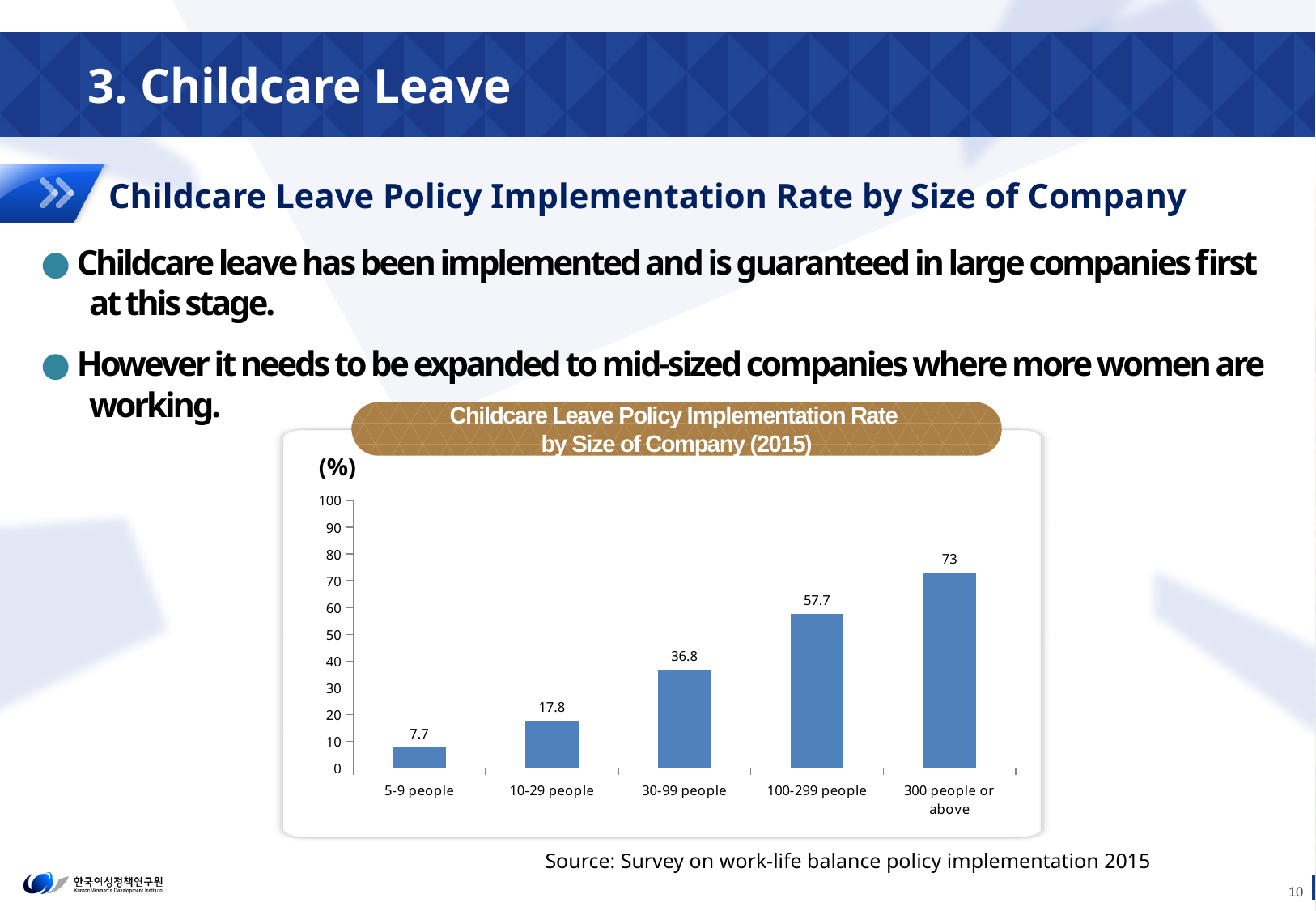
Which company size category has the lowest implementation rate? 5-9 people What year is given in the chart title? 2015 Which company size category has the highest implementation rate? 300 people or above What is the difference between the implementation rates for companies with 300 people or above and companies with 10-29 people? 55.2 How many company size categories are shown in the chart? 5 What is the implementation rate for companies with 30-99 people? 36.8 What is the childcare leave policy implementation rate for companies with 5-9 people? 7.7 Is the implementation rate for companies with 10-29 people greater or less than 20? less What type of chart is shown on the slide? Bar chart Do the implementation rates rise or fall as company size increases along the x axis? Rise What is the implementation rate for companies with 100-299 people? 57.7 Which has a higher implementation rate: companies with 30-99 people or companies with 100-299 people? 100-299 people